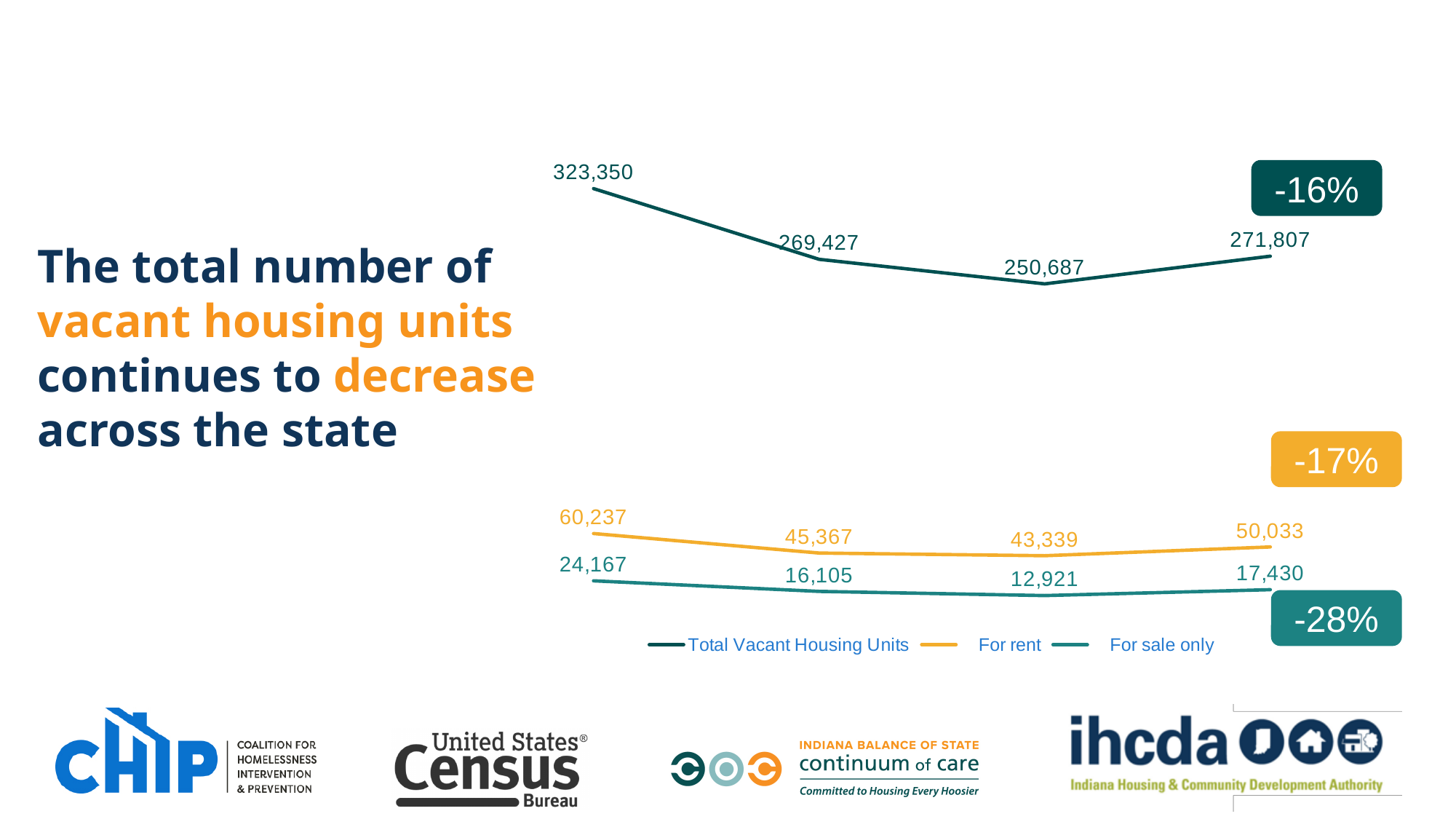
What is the difference between the first and last values of the Total Vacant Housing Units line? 51,543 What is the lowest value on the Total Vacant Housing Units line? 250,687 How many data points does the Total Vacant Housing Units line have? 4 At the last data point, which is larger: For rent or For sale only? For rent How many series does the legend list? 3 What percentage change is shown in the label next to the For sale only line? -28% What kind of chart is shown on the slide? line chart What is the second value on the For rent line? 45,367 What is the first (leftmost) value of the Total Vacant Housing Units line? 323,350 What is the difference between the first and last values of the For sale only line? 6,737 What is the last (rightmost) value on the For sale only line? 17,430 What is the highest value on the For rent line? 60,237